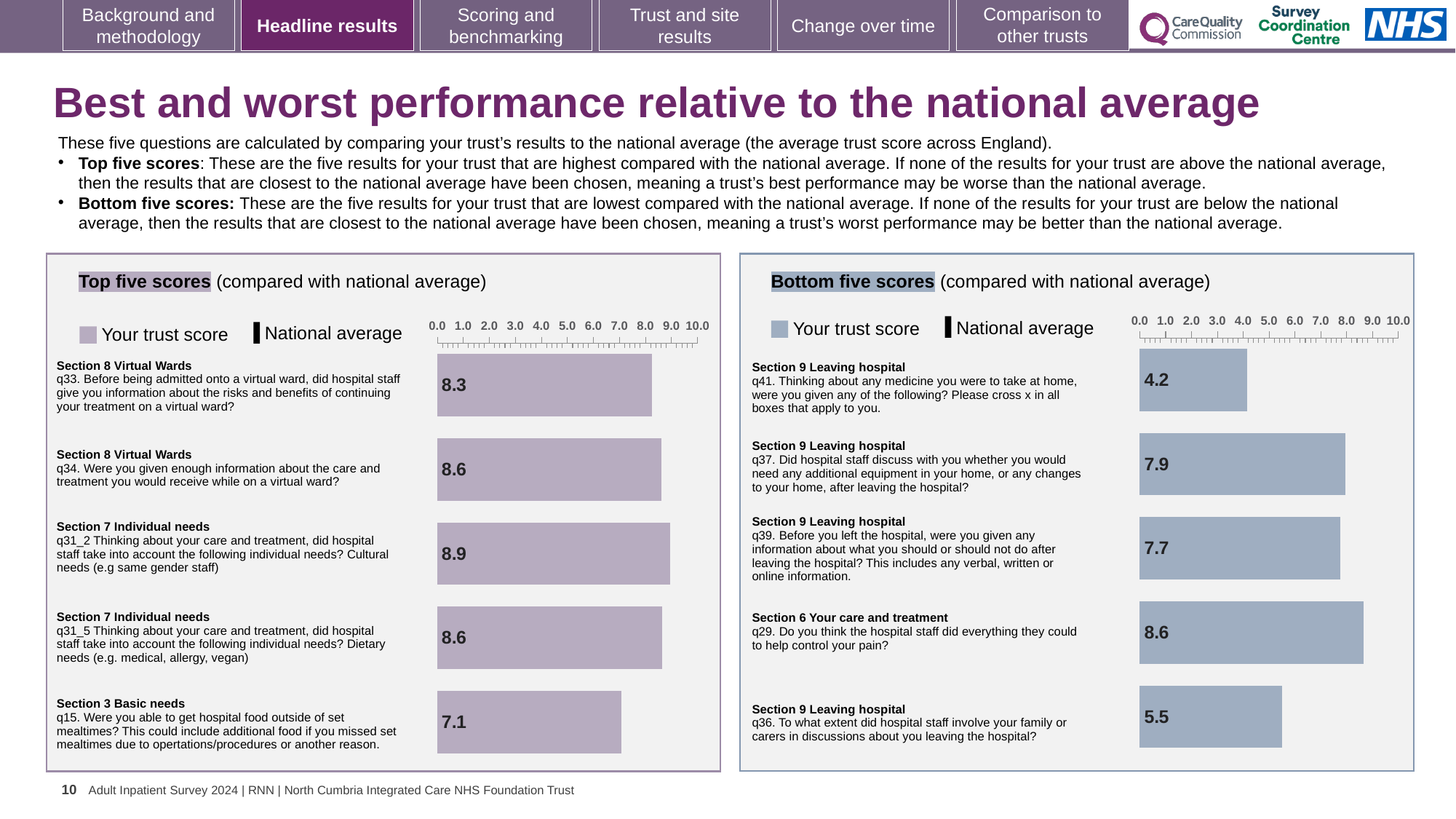
In the Top five scores chart, which question has the highest trust score? q31_2 (Cultural needs), 8.9 In the Bottom five scores chart, what is the difference between the score for q29 (control your pain) and the score for q41 (medicine to take at home)? 4.4 In the Bottom five scores chart, which question has the highest trust score? q29 (control your pain), 8.6 How many series does the legend of the Top five scores chart list? 2 In the Bottom five scores chart, which has the larger trust score: q37 (additional equipment in your home) or q39 (information about what to do after leaving hospital)? q37 (7.9) What kind of chart is used in the Bottom five scores panel? Bar chart In the Top five scores chart, which question has the lowest trust score? q15 (hospital food outside of set mealtimes), 7.1 In the Top five scores chart, what is the trust score for q33 (information about risks and benefits of continuing treatment on a virtual ward)? 8.3 In the Top five scores chart, what is the difference between the score for q31_2 (Cultural needs) and the score for q15 (food outside set mealtimes)? 1.8 In the Bottom five scores chart, what is the trust score for q36 (involving family or carers in discussions about leaving hospital)? 5.5 How many bars are plotted in the Top five scores chart? 5 In the Bottom five scores chart, which question has the lowest trust score? q41 (medicine to take at home), 4.2